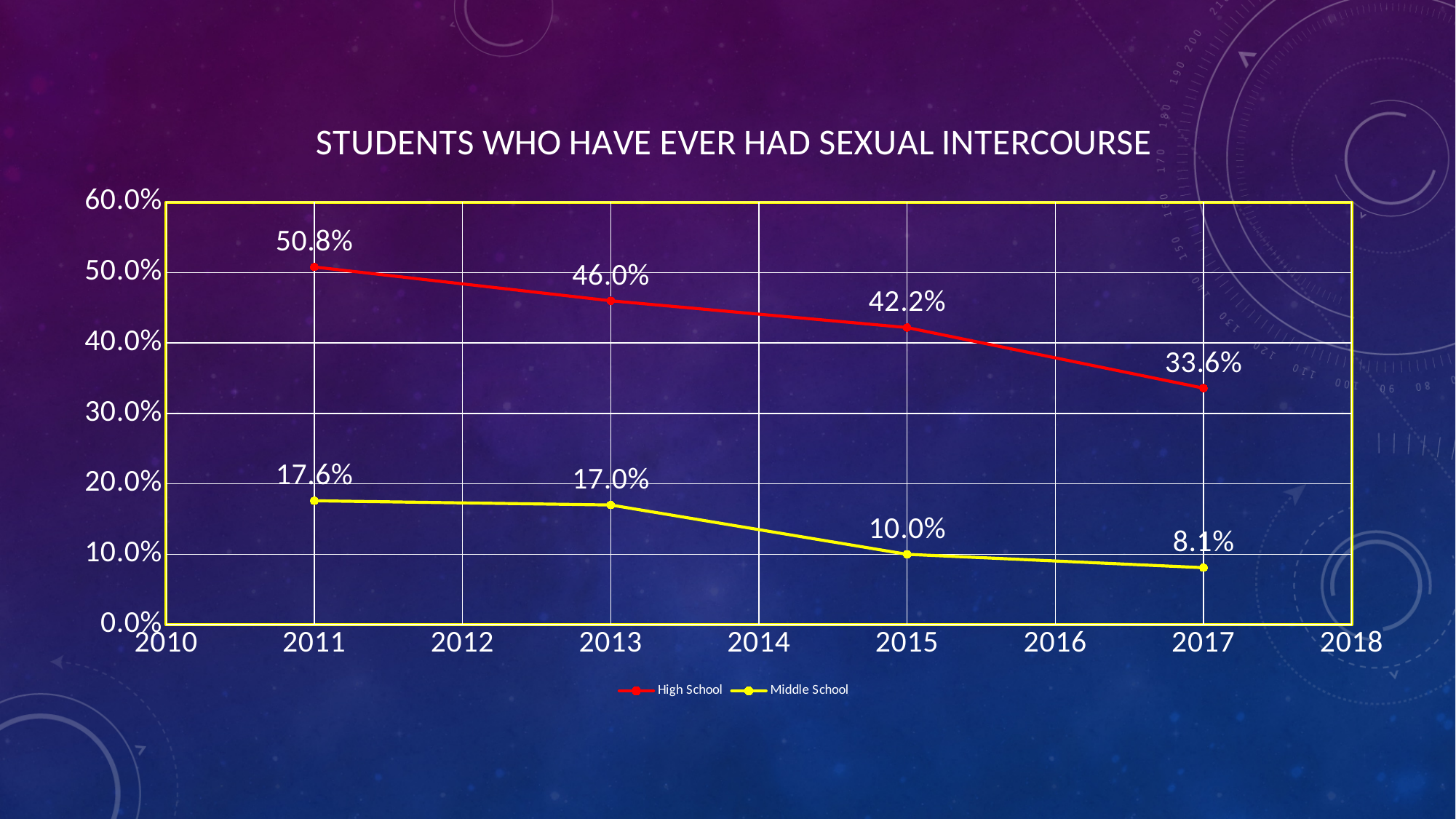
How many data points are plotted for the High School series? 4 Do the High School values rise or fall from 2011 to 2017? Fall In which year is the High School value highest? 2011 What kind of chart is shown? Line chart What is the High School value in 2011? 50.8% How many series does the legend list? 2 What is the High School value in 2017? 33.6% What is the Middle School value in 2015? 10.0% In which year is the Middle School value lowest? 2017 What is the difference between the High School values in 2011 and 2017? 17.2% Which is larger in 2015, the High School value or the Middle School value? High School What is the Middle School value in 2013? 17.0%